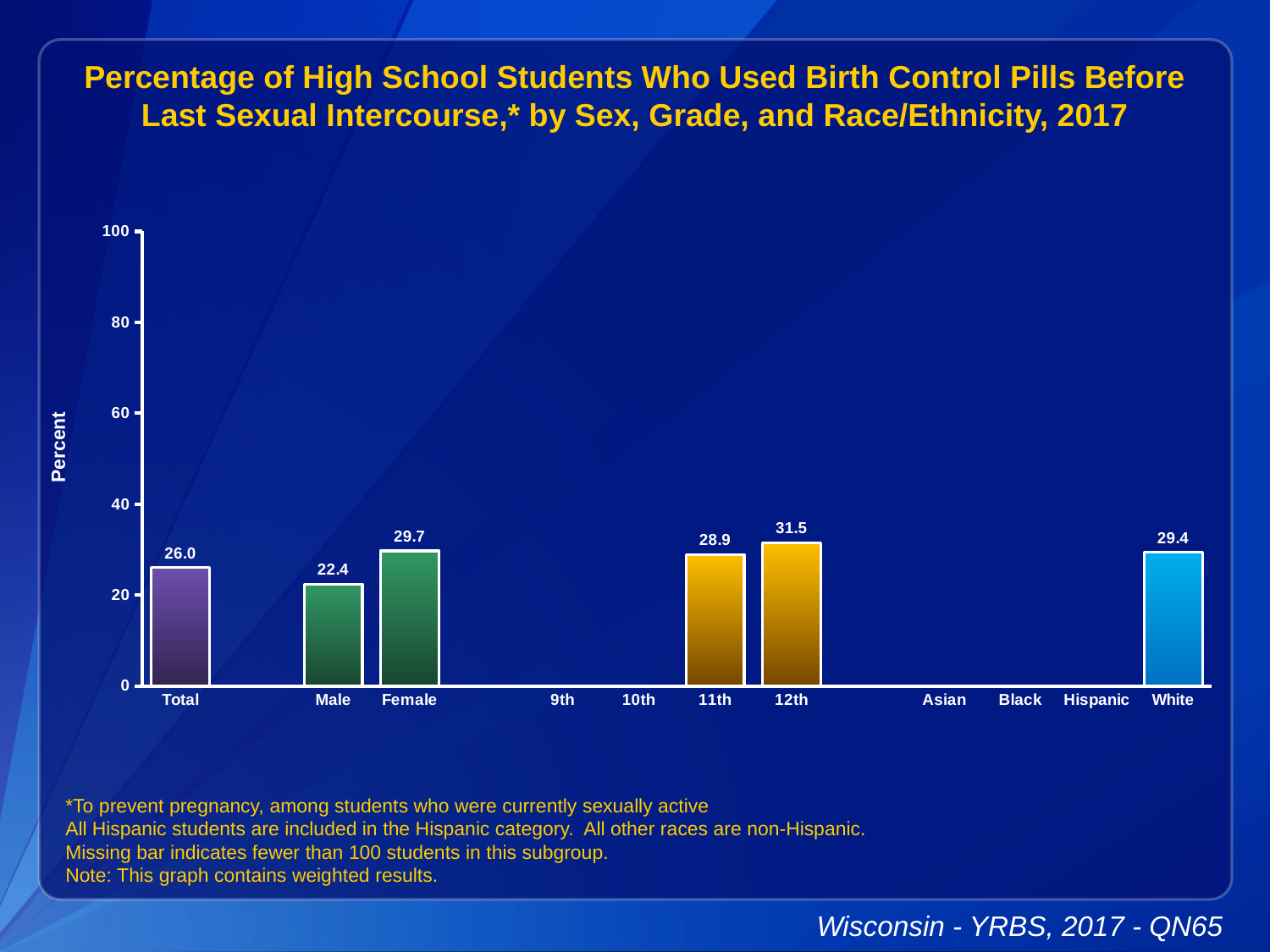
What kind of chart is shown on the slide? bar chart Which is larger, the value for 11th grade or the value for 12th grade? 12th What is the difference between the Female and Male values? 7.3 What is the value for Male? 22.4 What is the value for Total? 26.0 What is the label on the vertical axis? Percent What is the value for White? 29.4 What is the value for 12th grade? 31.5 Which category has the lowest value among the bars shown? Male What is the value for Female? 29.7 How many bars are plotted on the chart? 6 Which category has the highest value among the bars shown? 12th